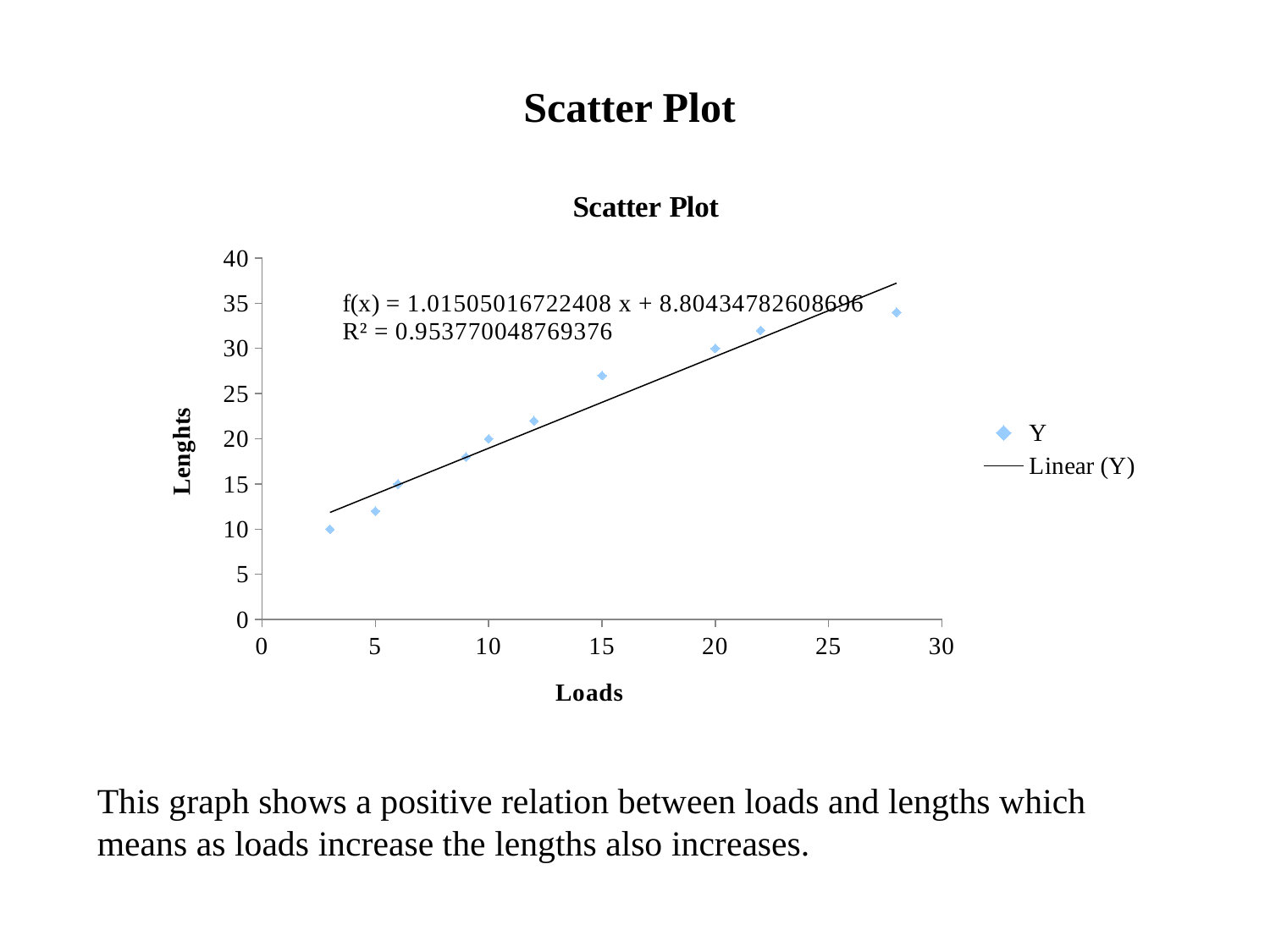
At which load does the highest length value occur? 28 How many data points are plotted in the scatter plot? 10 What kind of chart is shown on the slide? Scatter plot What is the length value for the point at load 20? 30 At which load does the lowest length value occur? 3 Is the length for the point at load 3 greater or less than 15? less How many entries does the legend list? 2 What is the length value for the point at load 10? 20 Is the length for the point at load 28 greater or less than 30? greater What is the R² value printed on the chart? 0.953770048769376 Do the lengths rise or fall as the loads increase along the x axis? Rise What is the label of the x axis? Loads